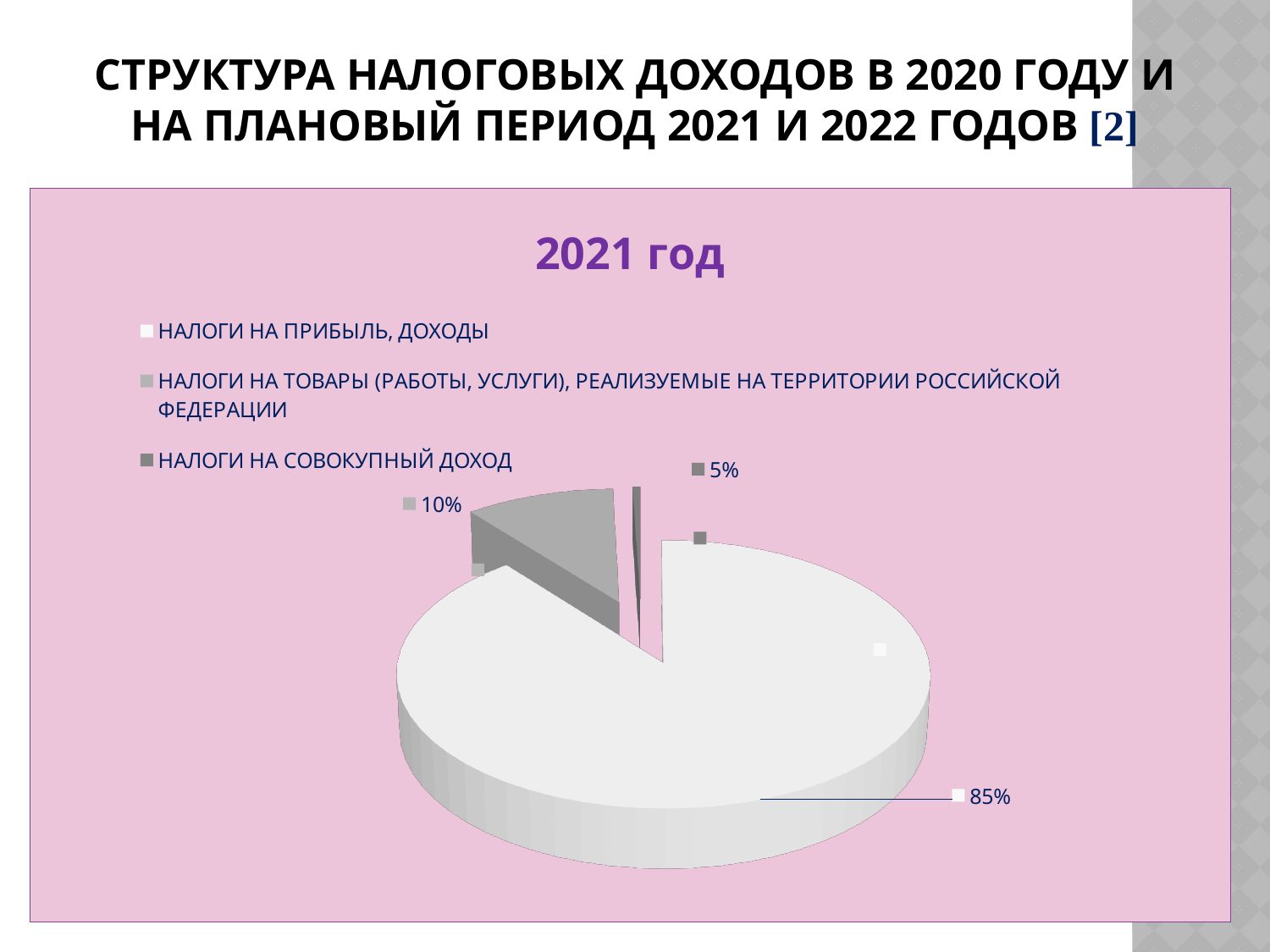
What is the difference in percentage points between the share of НАЛОГИ НА ПРИБЫЛЬ, ДОХОДЫ and the share of НАЛОГИ НА ТОВАРЫ (РАБОТЫ, УСЛУГИ), РЕАЛИЗУЕМЫЕ НА ТЕРРИТОРИИ РОССИЙСКОЙ ФЕДЕРАЦИИ? 75% What share of the pie is НАЛОГИ НА ПРИБЫЛЬ, ДОХОДЫ? 85% Which category has the smallest slice of the pie? НАЛОГИ НА СОВОКУПНЫЙ ДОХОД What is the title of the chart? 2021 год What type of chart is shown on the slide? pie chart What share of the pie is НАЛОГИ НА ТОВАРЫ (РАБОТЫ, УСЛУГИ), РЕАЛИЗУЕМЫЕ НА ТЕРРИТОРИИ РОССИЙСКОЙ ФЕДЕРАЦИИ? 10% What share of the pie is НАЛОГИ НА СОВОКУПНЫЙ ДОХОД? 5% How many slices does the pie chart have? 3 Which is larger: the share of НАЛОГИ НА ТОВАРЫ (РАБОТЫ, УСЛУГИ), РЕАЛИЗУЕМЫЕ НА ТЕРРИТОРИИ РОССИЙСКОЙ ФЕДЕРАЦИИ or the share of НАЛОГИ НА СОВОКУПНЫЙ ДОХОД? НАЛОГИ НА ТОВАРЫ (РАБОТЫ, УСЛУГИ), РЕАЛИЗУЕМЫЕ НА ТЕРРИТОРИИ РОССИЙСКОЙ ФЕДЕРАЦИИ What colour is the slice representing НАЛОГИ НА ПРИБЫЛЬ, ДОХОДЫ? white How many entries does the legend list? 3 Which category has the largest slice of the pie? НАЛОГИ НА ПРИБЫЛЬ, ДОХОДЫ